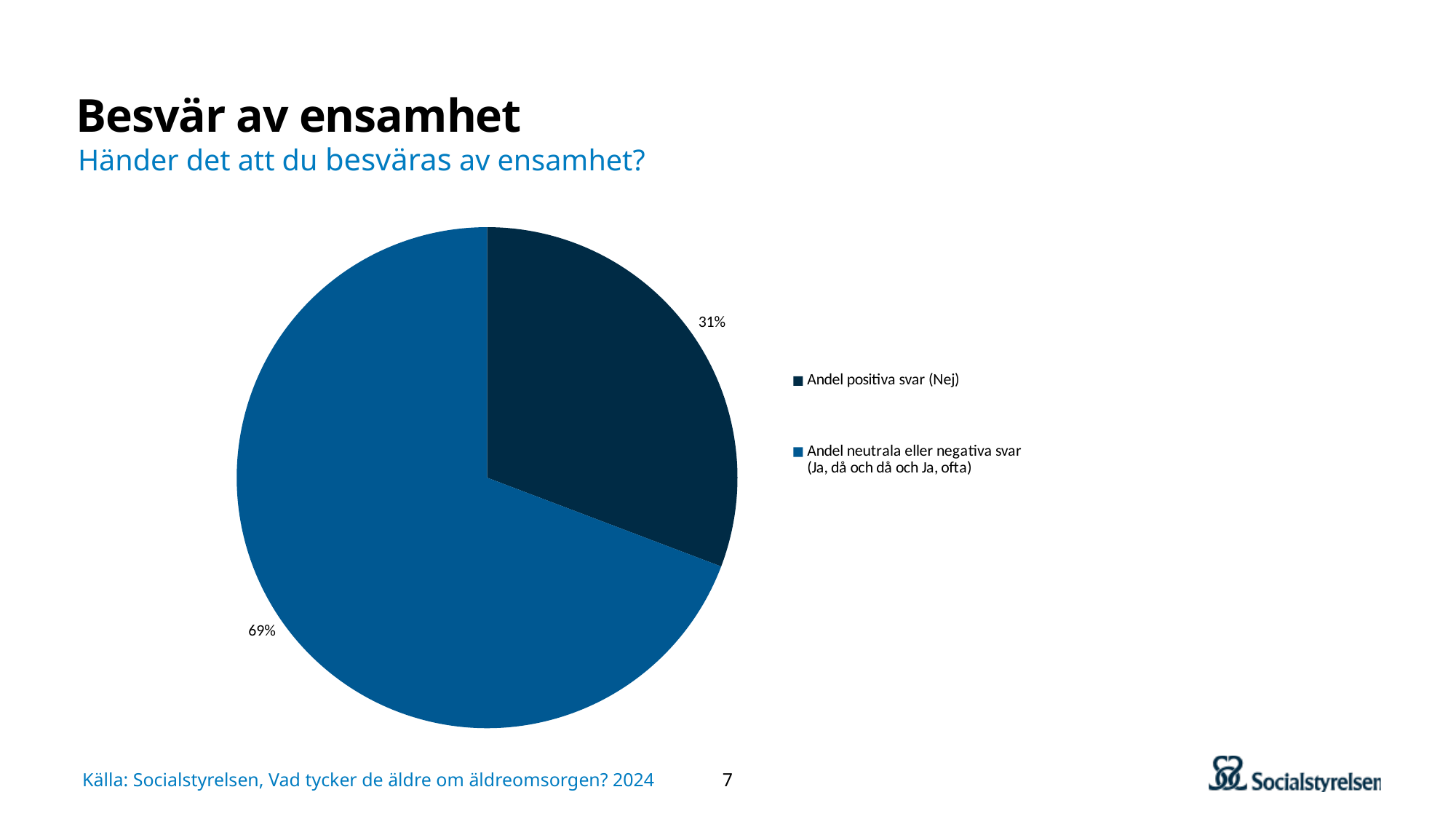
Which slice of the pie is the largest? Andel neutrala eller negativa svar (Ja, då och då och Ja, ofta) What question is shown as the subtitle above the chart? Händer det att du besväras av ensamhet? How many entries does the legend list? 2 What kind of chart is shown on the slide? Pie chart Is the share of positive answers (Nej) greater or less than 50%? less Which slice of the pie is the smallest? Andel positiva svar (Nej) What is the source cited at the bottom of the slide? Socialstyrelsen, Vad tycker de äldre om äldreomsorgen? 2024 Which is larger: the share of positive answers (Nej) or the share of neutral or negative answers? Andel neutrala eller negativa svar What share of the pie is labelled 'Andel positiva svar (Nej)'? 31% What share of the pie is labelled 'Andel neutrala eller negativa svar (Ja, då och då och Ja, ofta)'? 69% What is the difference in percentage points between the two slices of the pie? 38 percentage points How many slices does the pie chart have? 2